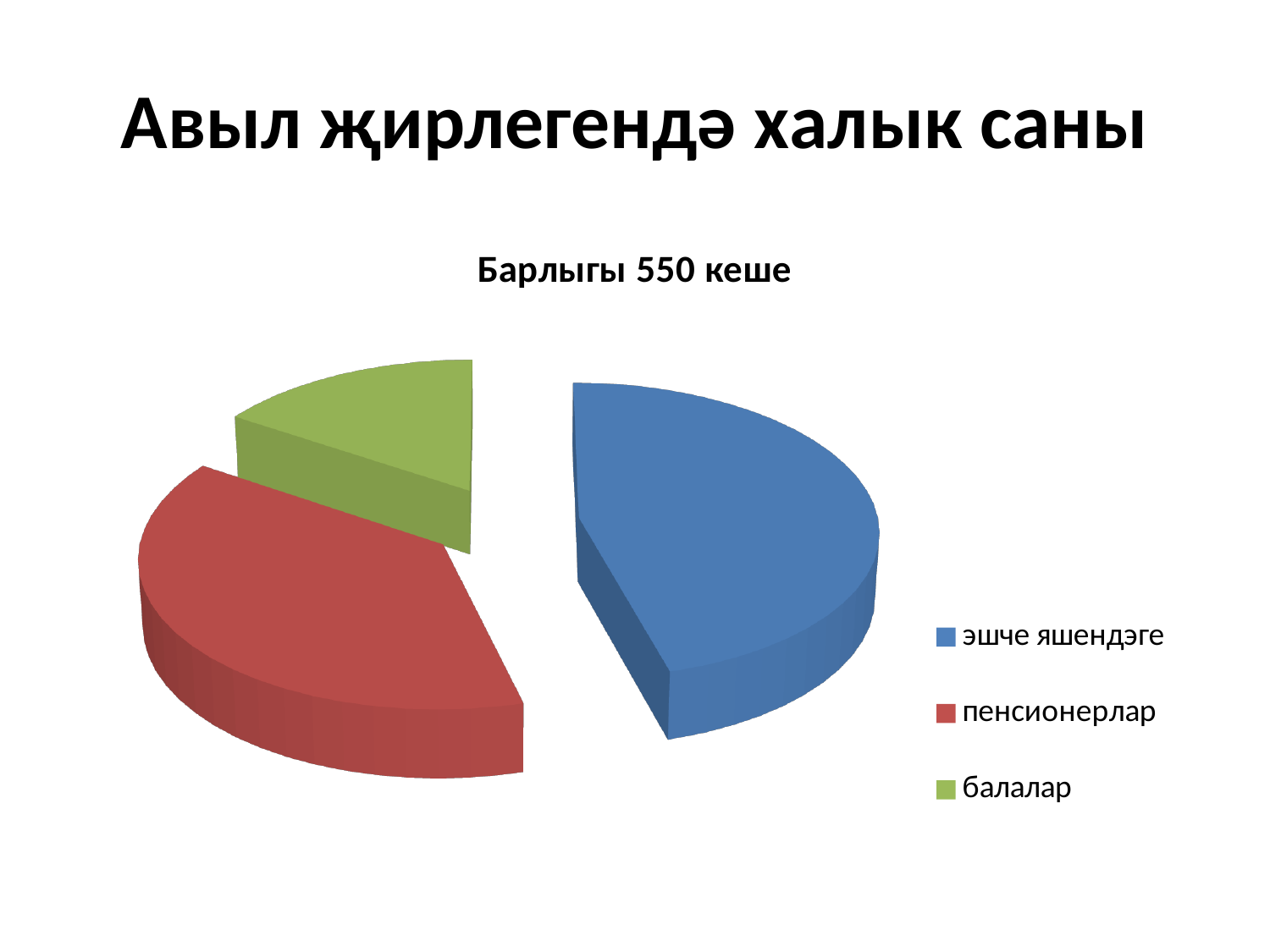
Which slice is smaller, балалар or эшче яшендэге? балалар Which category has the smallest slice of the pie? балалар How many entries does the legend list? 3 What colour is the slice for пенсионерлар? red How many slices does the pie chart have? 3 Which slice is larger, эшче яшендэге or пенсионерлар? эшче яшендэге Which slice is larger, пенсионерлар or балалар? пенсионерлар Which category has the largest slice of the pie? эшче яшендэге What is the title of the chart? Барлыгы 550 кеше What kind of chart is shown on the slide? pie chart